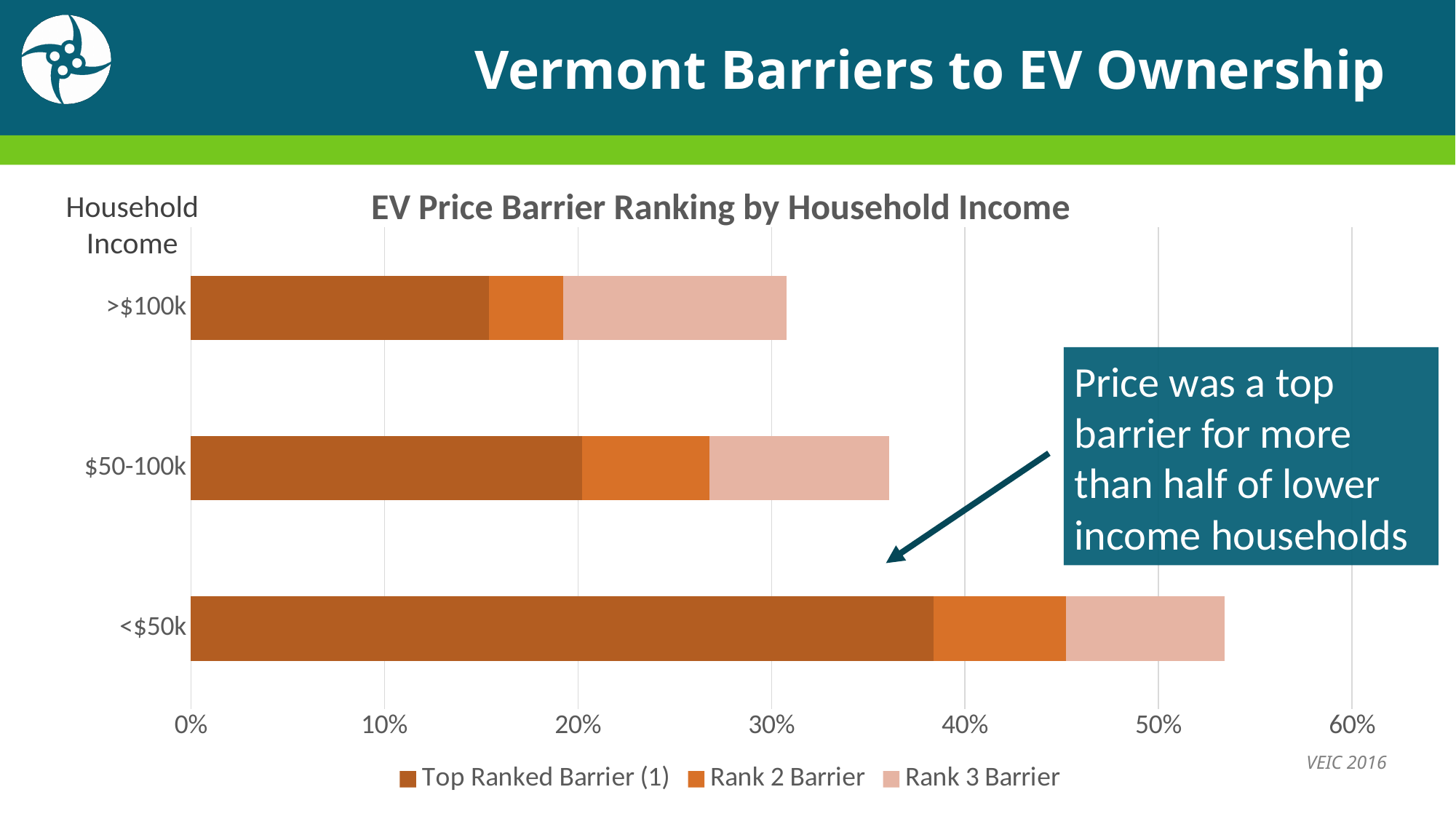
What is the name of the series shown in the lightest colour in the legend? Rank 3 Barrier What kind of chart is shown on the slide? Stacked bar chart Which household income category has the largest Top Ranked Barrier (1) segment? <$50k How many series does the legend list? 3 Which household income category has the longest total bar? <$50k Is the total bar for $50-100k greater or less than 30%? greater Is the total bar for <$50k greater or less than 50%? greater Is the Top Ranked Barrier (1) value for >$100k greater or less than 20%? less Which is larger, the Top Ranked Barrier (1) value for $50-100k or for >$100k? $50-100k What is the title of the chart? EV Price Barrier Ranking by Household Income Which household income category has the shortest total bar? >$100k How many household income categories are shown on the chart? 3